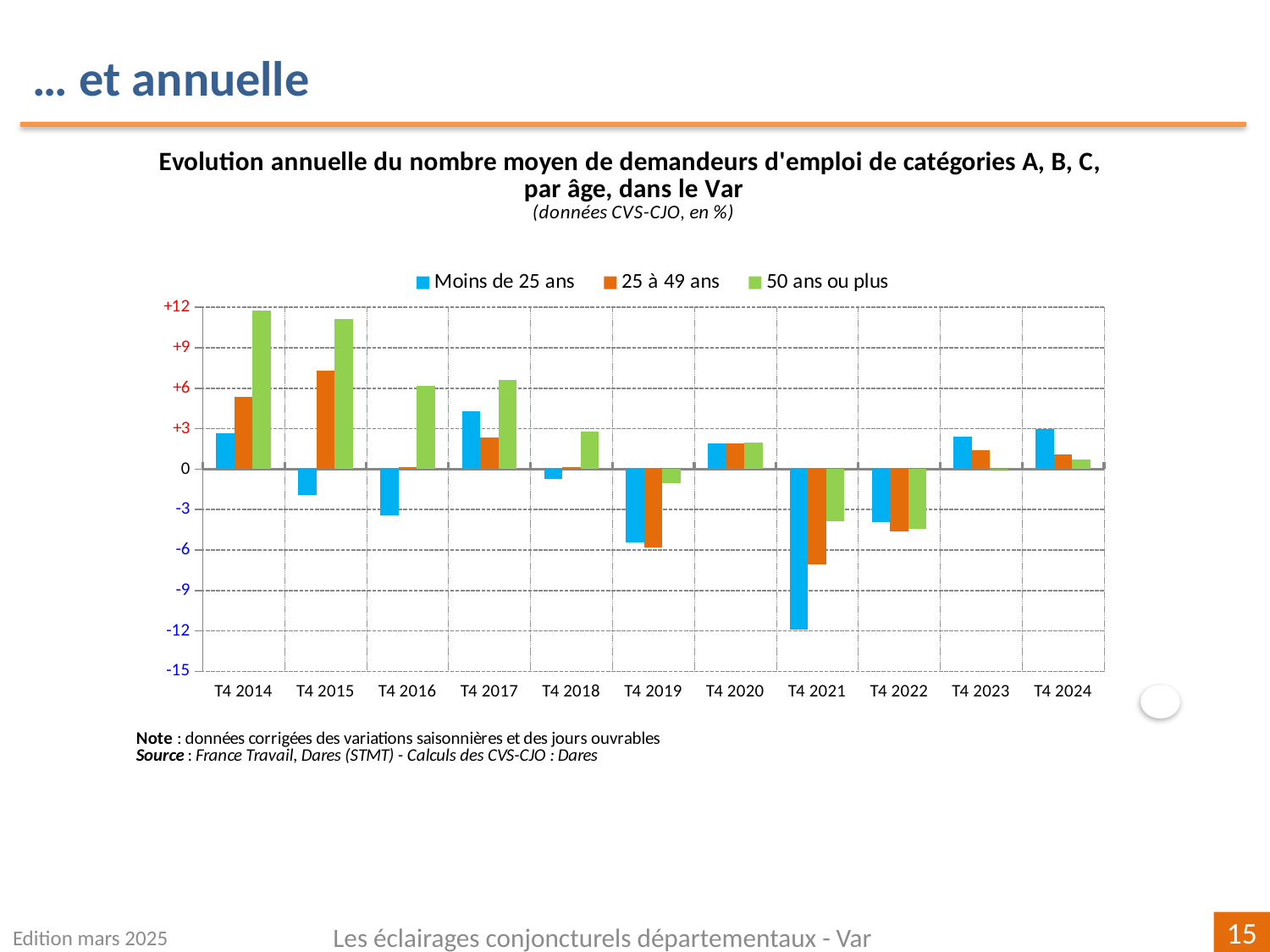
Which colour represents the series '50 ans ou plus' in the legend? green In T4 2021, which is larger: the value for '25 à 49 ans' or for '50 ans ou plus'? 50 ans ou plus For the series '25 à 49 ans', which period has the highest value? T4 2015 Is the value for '50 ans ou plus' in T4 2016 greater or less than +3? greater What kind of chart is shown on the slide? bar chart For the series 'Moins de 25 ans', which period has the lowest value? T4 2021 How many series does the legend list? 3 How many periods (categories) are shown on the x axis? 11 Is the value for 'Moins de 25 ans' in T4 2021 greater or less than -9? less In T4 2017, which is larger: the value for 'Moins de 25 ans' or for '25 à 49 ans'? Moins de 25 ans Is the value for '50 ans ou plus' in T4 2014 greater or less than +9? greater